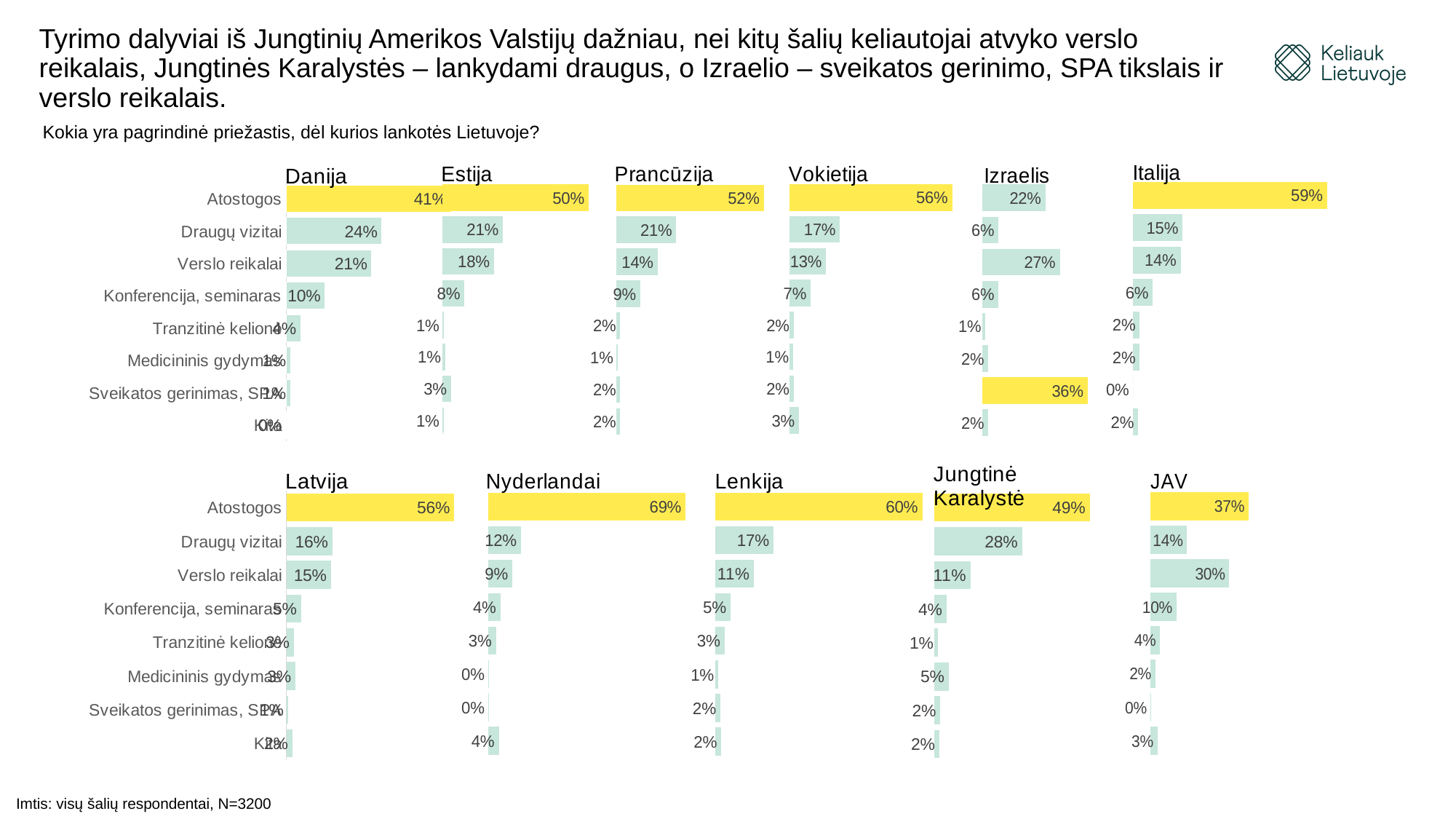
In the Izraelis chart, what is the value for Sveikatos gerinimas, SPA? 36% In the JAV chart, what is the value for Verslo reikalai? 30% In the Danija chart, which category has the lowest value? Kita In the Vokietija chart, what is the difference between Atostogos and Draugų vizitai? 39 percentage points Which is larger: Verslo reikalai in the Izraelis chart or Verslo reikalai in the JAV chart? JAV What type of chart is used for each country on the slide? Bar chart How many categories does each country chart show? 8 In the JAV chart, what is the difference between Atostogos and Verslo reikalai? 7 percentage points In the Nyderlandai chart, which category has the highest value? Atostogos Which is larger: Atostogos in the Lenkija chart or Atostogos in the Latvija chart? Lenkija In the Izraelis chart, which category has the highest value? Sveikatos gerinimas, SPA In the Jungtinė Karalystė chart, what is the value for Draugų vizitai? 28%